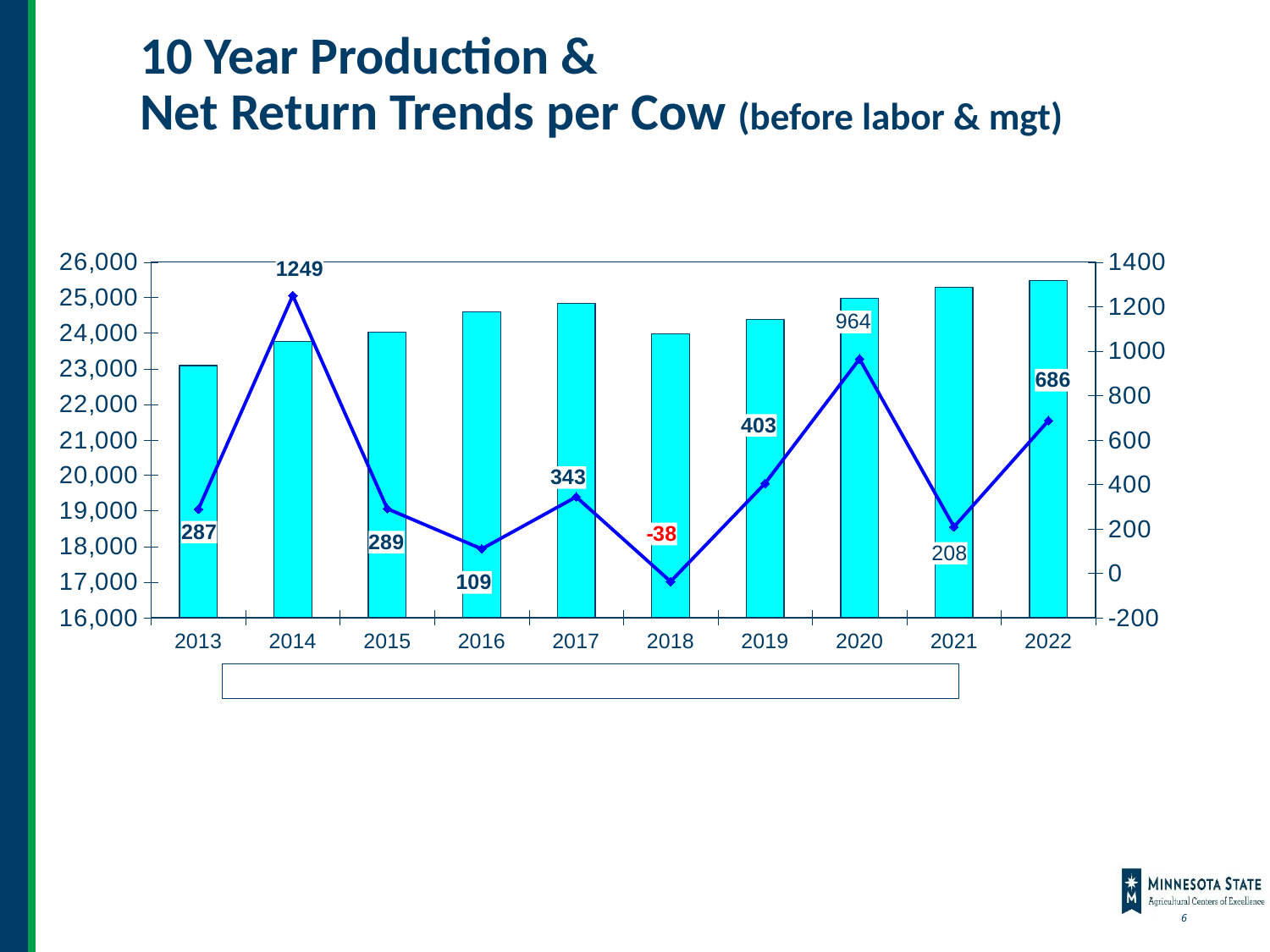
What is the data label on the line for 2018? -38 Is the bar value for 2022 greater or less than 25,000 on the left axis? greater What kind of chart is shown on the slide? Combination bar and line chart Is the bar value for 2013 greater or less than 24,000 on the left axis? less Which year has the shortest bar? 2013 Which year has the larger line value, 2017 or 2019? 2019 In which year does the line series reach its highest value? 2014 What is the data label on the line for 2014? 1249 In which year does the line series reach its lowest value? 2018 What is the difference between the line values for 2020 and 2021? 756 How many years are shown on the x axis? 10 What is the data label on the line for 2022? 686